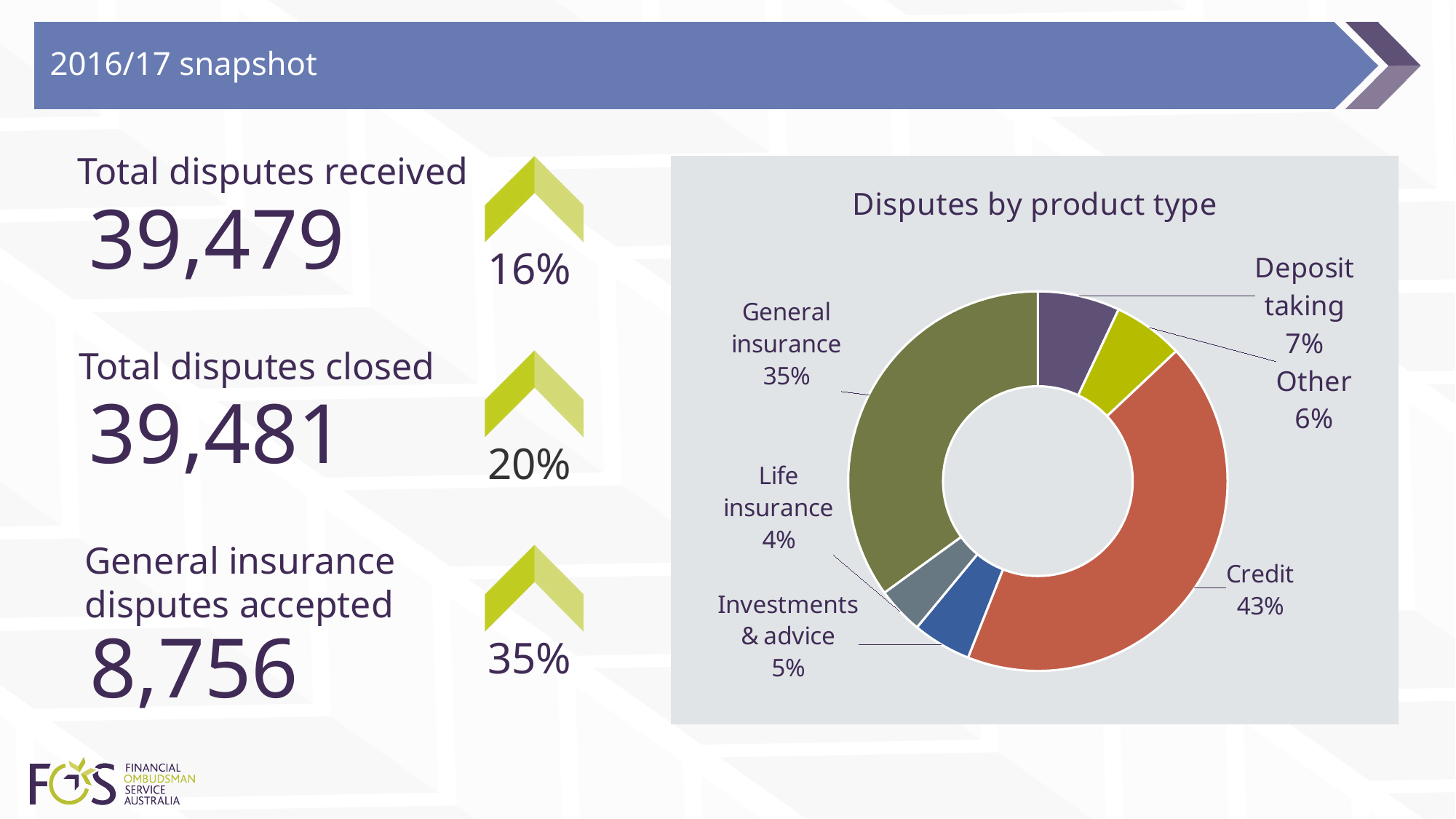
Which product type has the smallest share in the 'Disputes by product type' chart? Life insurance How many product type categories are shown in the 'Disputes by product type' chart? 6 What share of disputes is Investments & advice in the 'Disputes by product type' chart? 5% What kind of chart is 'Disputes by product type'? Doughnut (pie) chart What share of disputes is Credit in the 'Disputes by product type' chart? 43% In the 'Disputes by product type' chart, what is the combined share of General insurance and Life insurance? 39% What share of disputes is General insurance in the 'Disputes by product type' chart? 35% What share of disputes is Deposit taking in the 'Disputes by product type' chart? 7% In the 'Disputes by product type' chart, what is the difference in percentage points between Credit and General insurance? 8 In the 'Disputes by product type' chart, which is larger: Deposit taking or Other? Deposit taking What is the title of the chart on the slide? Disputes by product type Which product type has the largest share in the 'Disputes by product type' chart? Credit